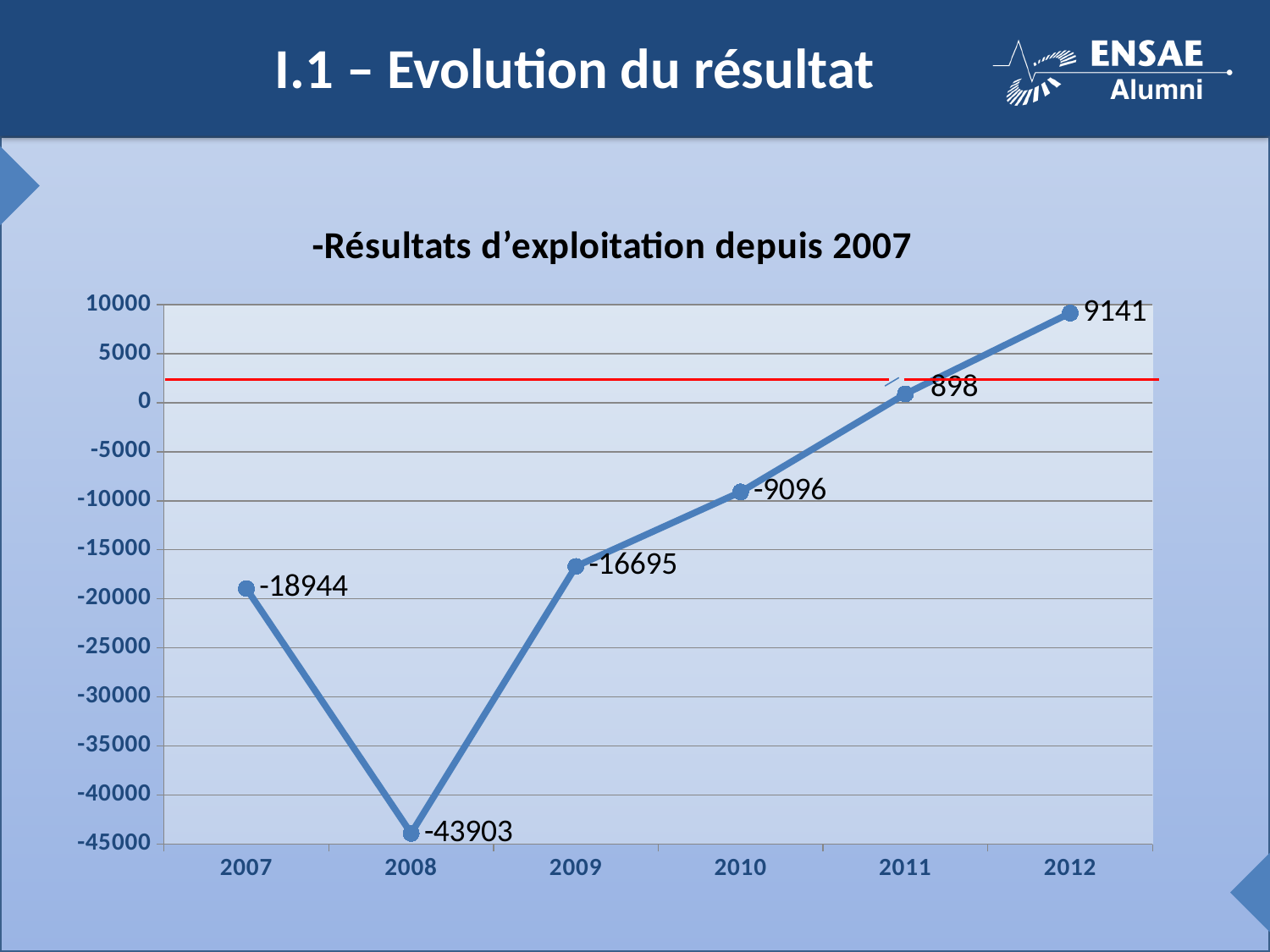
How many years are plotted on the chart? 6 Do the values rise or fall from 2008 to 2012? rise What is the value for 2010? -9096 What is the difference between the values for 2007 and 2008? 24959 Which year has the lowest value? 2008 What is the value for 2008? -43903 Which year has the highest value? 2012 Which is larger, the value for 2007 or the value for 2009? 2009 What is the difference between the values for 2012 and 2011? 8243 What is the value for 2012? 9141 What is the value for 2011? 898 What kind of chart is shown on the slide? line chart